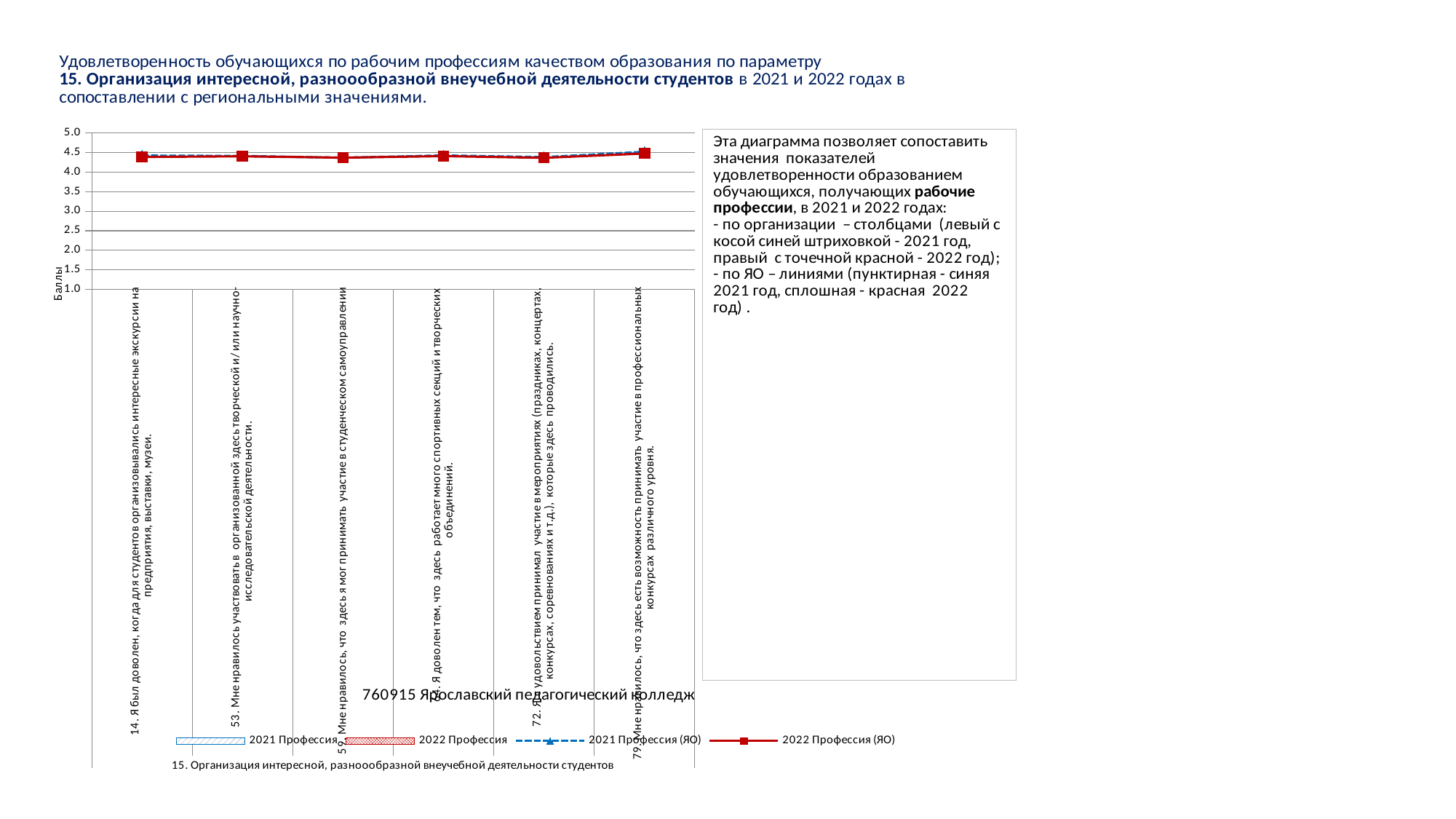
Is the value for category 72 in the 2022 Профессия (ЯО) series greater or less than 4.0? greater Is the value for category 79 in the 2022 Профессия (ЯО) series greater or less than 5.0? less How many series does the chart legend list? 4 Is the value for category 14 in the 2022 Профессия (ЯО) series greater or less than 4.0? greater What is the label of the vertical axis of the chart? Баллы What is the highest tick value shown on the vertical axis? 5.0 How many categories are shown along the x axis of the chart? 6 What is the lowest tick value shown on the vertical axis? 1.0 Which category has the highest value in the 2022 Профессия (ЯО) series? 79. Мне нравилось, что здесь есть возможность принимать участие в профессиональных конкурсах различного уровня.